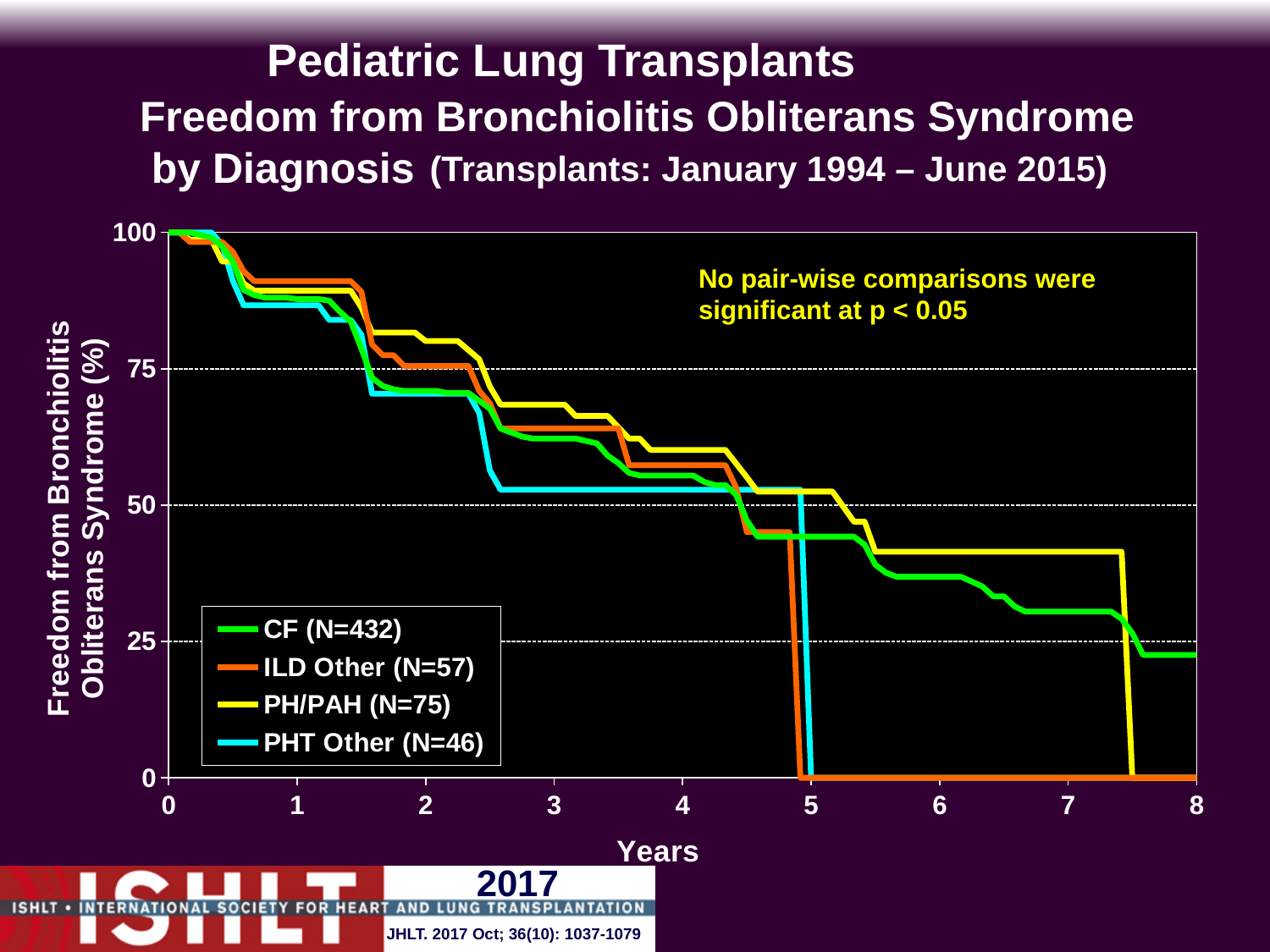
How many series does the legend list? 4 Is the value for the PHT Other curve at 3 years greater or less than 50? greater Is the value for the CF curve at 8 years greater or less than 25? less Do the curves rise or fall as the years increase along the x axis? fall At 3 years, which of the four curves is the lowest? PHT Other What is the sample size (N) shown in the legend for the CF group? 432 What is the sample size (N) shown in the legend for the PHT Other group? 46 At 3 years, which curve is higher: PH/PAH or PHT Other? PH/PAH What is the label of the x axis? Years Is the value for the CF curve at 6 years greater or less than 50? less What kind of chart is shown on the slide? line chart